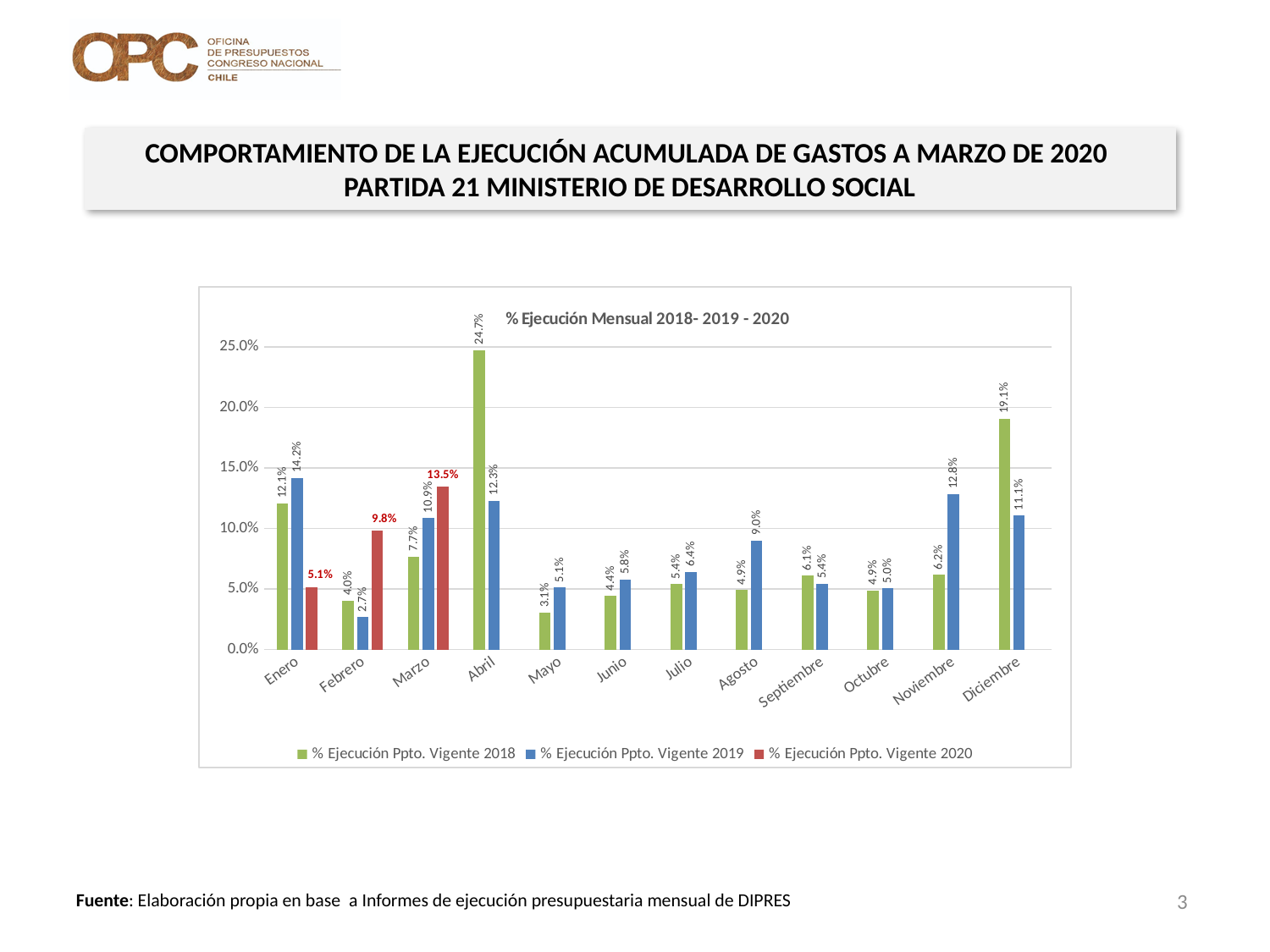
What is the difference between the 2019 and 2018 values in Enero? 2.1% Which month has the highest value for % Ejecución Ppto. Vigente 2018? Abril What kind of chart is shown on the slide? Bar chart How many months are shown on the x axis? 12 What is the value for % Ejecución Ppto. Vigente 2020 in Marzo? 13.5% What is the value for % Ejecución Ppto. Vigente 2018 in Diciembre? 19.1% Which is larger in Agosto: the 2018 value or the 2019 value? 2019 What is the value for % Ejecución Ppto. Vigente 2019 in Noviembre? 12.8% Is the value for % Ejecución Ppto. Vigente 2018 in Abril greater or less than 20.0%? greater What is the title of the chart? % Ejecución Mensual 2018- 2019 - 2020 How many series does the legend list? 3 Which month has the lowest value for % Ejecución Ppto. Vigente 2019? Febrero